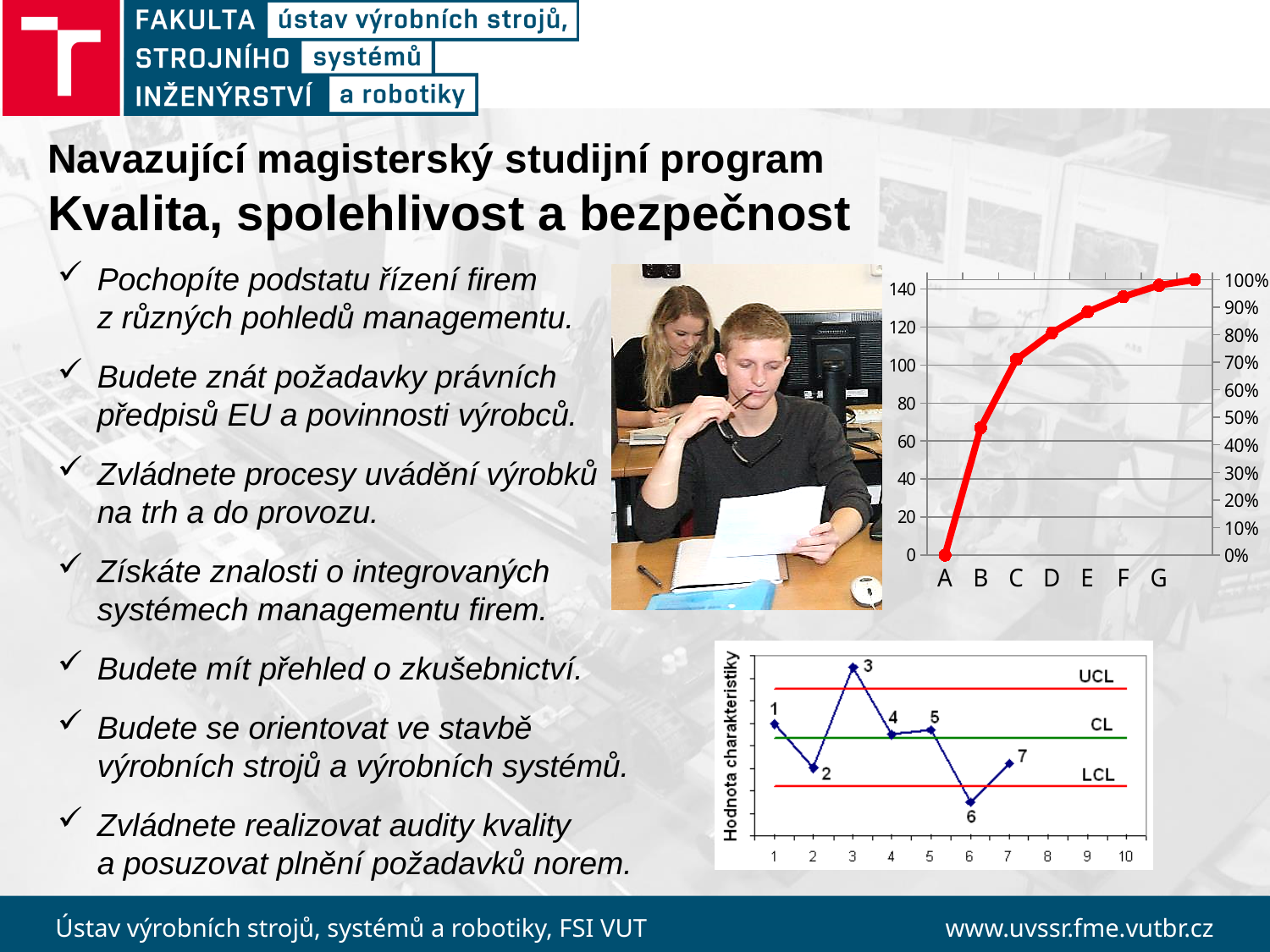
In the bottom-right control chart, which point has the lowest value? 6 In the top-right chart, how many categories are labelled on the x axis? 7 In the top-right chart, which labelled category has the highest value? G In the bottom-right control chart, which point has the highest value? 3 In the top-right chart, what is the value for category A? 0 In the bottom-right control chart, how many data points are plotted? 7 In the top-right chart, which labelled category has the lowest value? A In the top-right chart, what is the highest percentage shown on the right-hand axis? 100% In the top-right chart, do the values rise or fall from A to G? rise What kind of chart is the top-right chart with categories A to G? line chart